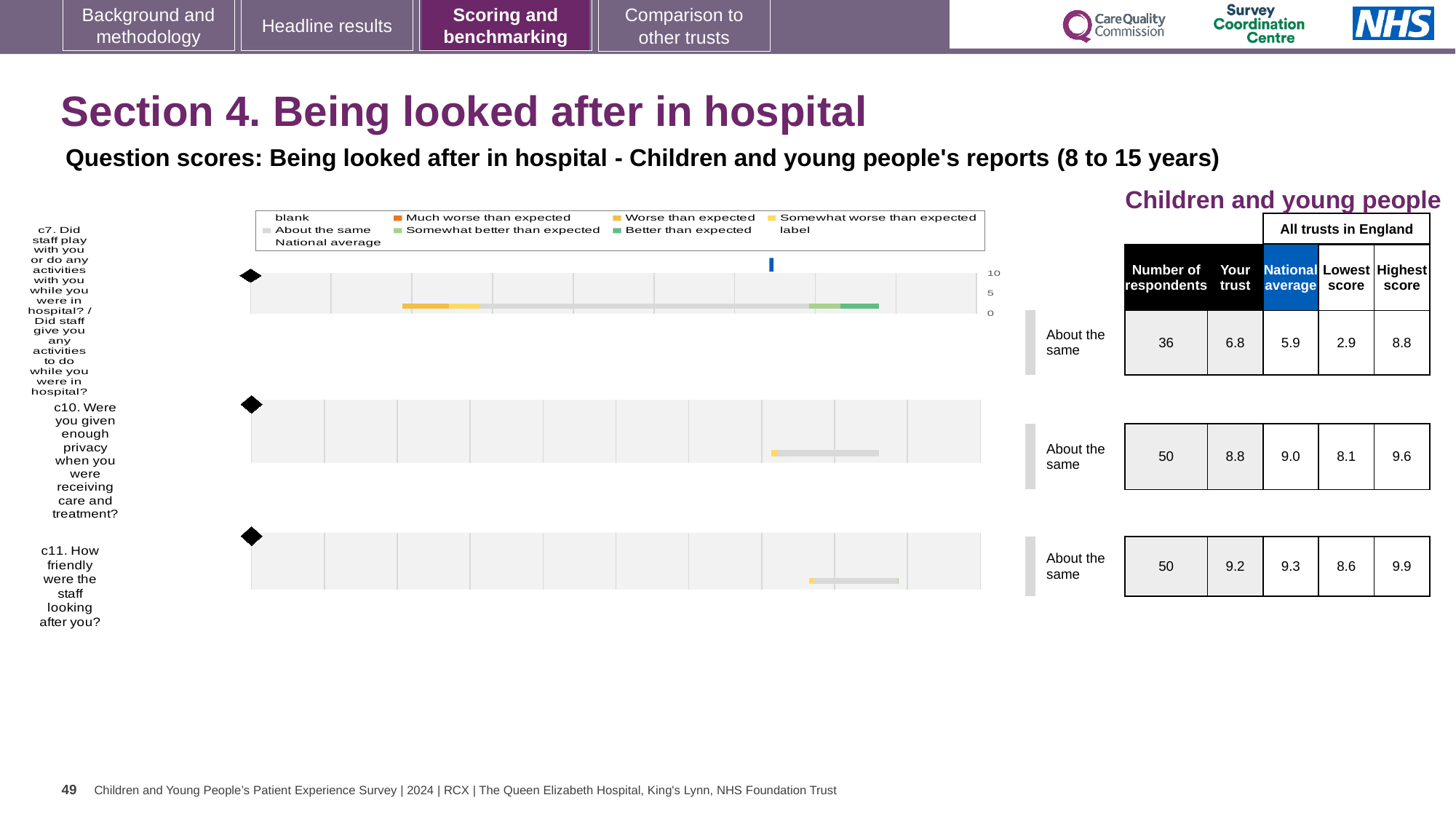
What is the national average score for question c10 (Were you given enough privacy when you were receiving care and treatment?)? 9.0 What kind of chart is used to show the question scores? Bar chart Is the 'Your trust' score for question c7 greater or less than 5? greater What is the highest score across all trusts in England for question c11 (How friendly were the staff looking after you?)? 9.9 How many questions are plotted on the slide? 3 What is the 'Your trust' score for question c7 (Did staff play with you or do any activities with you while you were in hospital?)? 6.8 Which question has the highest 'Your trust' score? c11. How friendly were the staff looking after you? Which question has the lowest 'Your trust' score? c7. Did staff play with you or do any activities with you while you were in hospital? For question c10, which is larger: the 'Your trust' score or the national average? National average What benchmark category is shown for all three questions? About the same What is the difference between the 'Your trust' score and the national average for question c7? 0.9 How many respondents answered question c7? 36